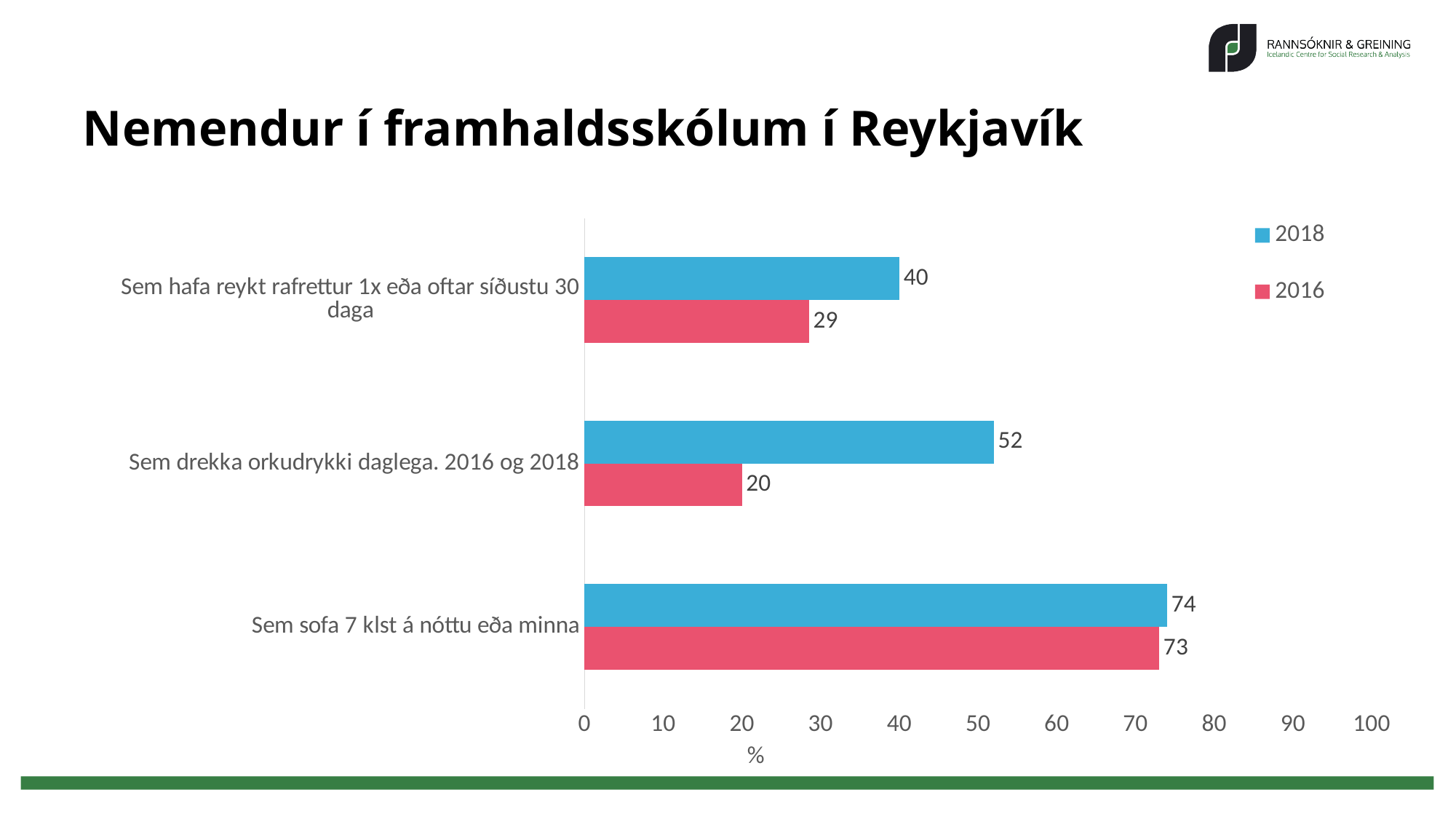
What is the 2018 value for "Sem hafa reykt rafrettur 1x eða oftar síðustu 30 daga"? 40 How many series does the legend list? 2 What is the 2016 value for "Sem sofa 7 klst á nóttu eða minna"? 73 Which category has the highest 2018 value? Sem sofa 7 klst á nóttu eða minna What is the 2016 value for "Sem drekka orkudrykki daglega. 2016 og 2018"? 20 How many categories are shown on the chart? 3 Is the 2018 value for "Sem drekka orkudrykki daglega. 2016 og 2018" greater or less than 50? greater Which category has the lowest 2016 value? Sem drekka orkudrykki daglega. 2016 og 2018 What kind of chart is shown on the slide? bar chart What is the difference between the 2018 and 2016 values for "Sem drekka orkudrykki daglega. 2016 og 2018"? 32 Which is larger for "Sem hafa reykt rafrettur 1x eða oftar síðustu 30 daga": the 2018 value or the 2016 value? 2018 What is the label of the horizontal axis? %